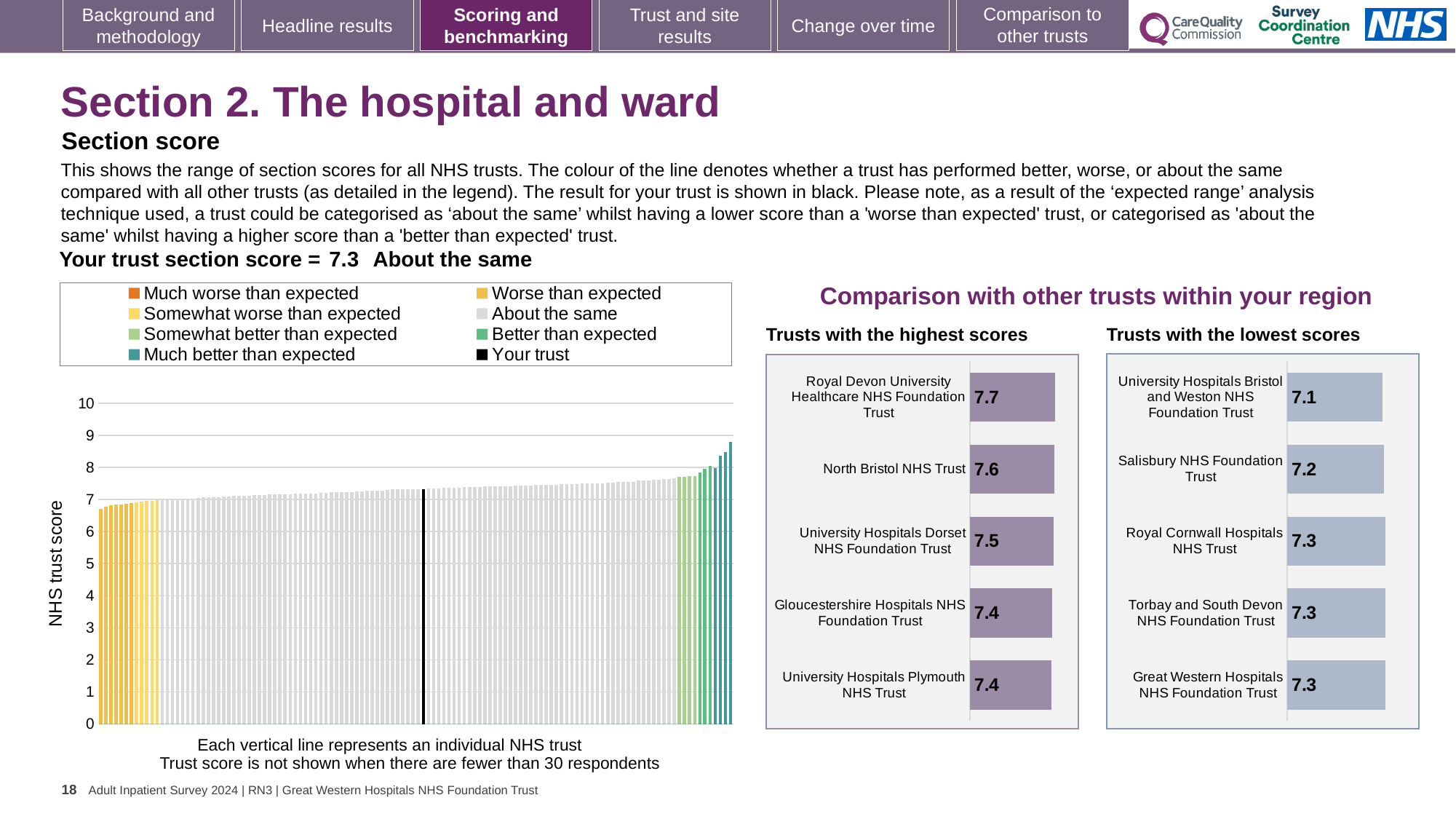
In the 'Trusts with the highest scores' chart, which trust has the highest score? Royal Devon University Healthcare NHS Foundation Trust In the 'Trusts with the lowest scores' chart, what is the score for Great Western Hospitals NHS Foundation Trust? 7.3 In the 'Trusts with the lowest scores' chart, which trust has the lowest score? University Hospitals Bristol and Weston NHS Foundation Trust How many trusts are listed in the 'Trusts with the highest scores' chart? 5 In the 'Trusts with the lowest scores' chart, which has the larger score: Salisbury NHS Foundation Trust or University Hospitals Bristol and Weston NHS Foundation Trust? Salisbury NHS Foundation Trust In the 'Trusts with the highest scores' chart, what is the score for Royal Devon University Healthcare NHS Foundation Trust? 7.7 In the large 'NHS trust score' chart on the left, is the value of the tallest bar greater or less than 8? greater In the 'Trusts with the lowest scores' chart, what is the score for Salisbury NHS Foundation Trust? 7.2 In the 'Trusts with the highest scores' chart, what is the score for University Hospitals Dorset NHS Foundation Trust? 7.5 In the 'Trusts with the highest scores' chart, what is the difference between the scores of Royal Devon University Healthcare NHS Foundation Trust and North Bristol NHS Trust? 0.1 How many entries does the legend of the large 'NHS trust score' chart list? 8 What kind of chart is the large 'NHS trust score' chart on the left of the slide? Bar chart